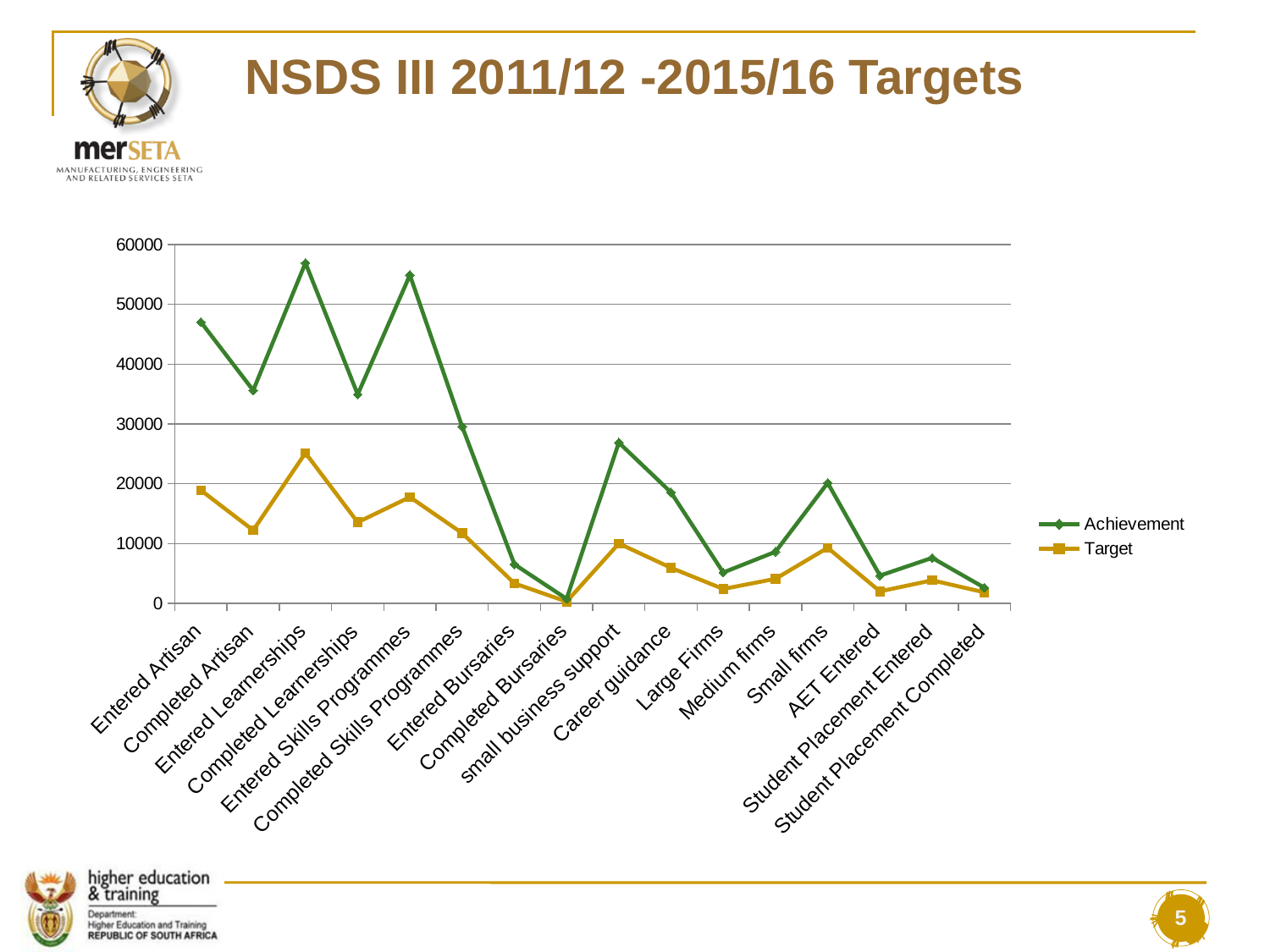
Which category has the highest Target value? Entered Learnerships What kind of chart is shown on the slide? line chart Is the Target value for Small firms greater or less than 10000? less Which category has the lowest Target value? Completed Bursaries For Entered Artisan, which is larger: Achievement or Target? Achievement How many series does the legend list? 2 Which has the larger Achievement value: Large Firms or Medium firms? Medium firms How many categories are plotted along the x axis? 16 Is the Target value for Entered Artisan greater or less than 20000? less What are the two series named in the legend? Achievement and Target